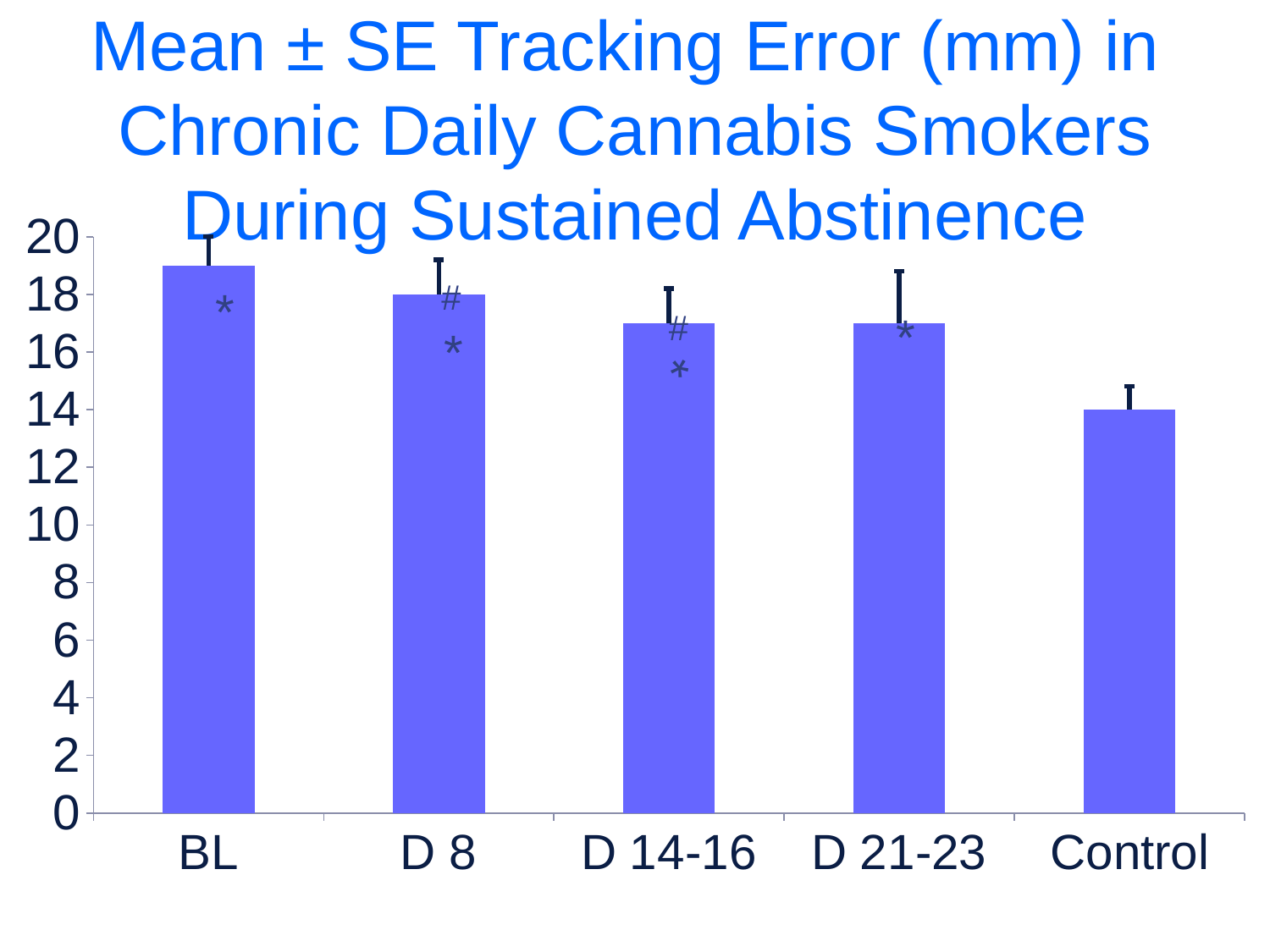
How many categories are shown on the x axis of the chart? 5 Is the value for D 21-23 greater or less than 18? less Which category has the highest tracking error? BL What is the tracking error value for D 8? 18 What is the difference between the values for D 8 and Control? 4 What kind of chart is shown on the slide? bar chart Which is larger, the value for BL or the value for Control? BL What is the tracking error value for Control? 14 Do the values rise or fall from BL to D 21-23? fall Is the value for BL greater or less than 18? greater Is the value for D 14-16 greater or less than 16? greater Which category has the lowest tracking error? Control